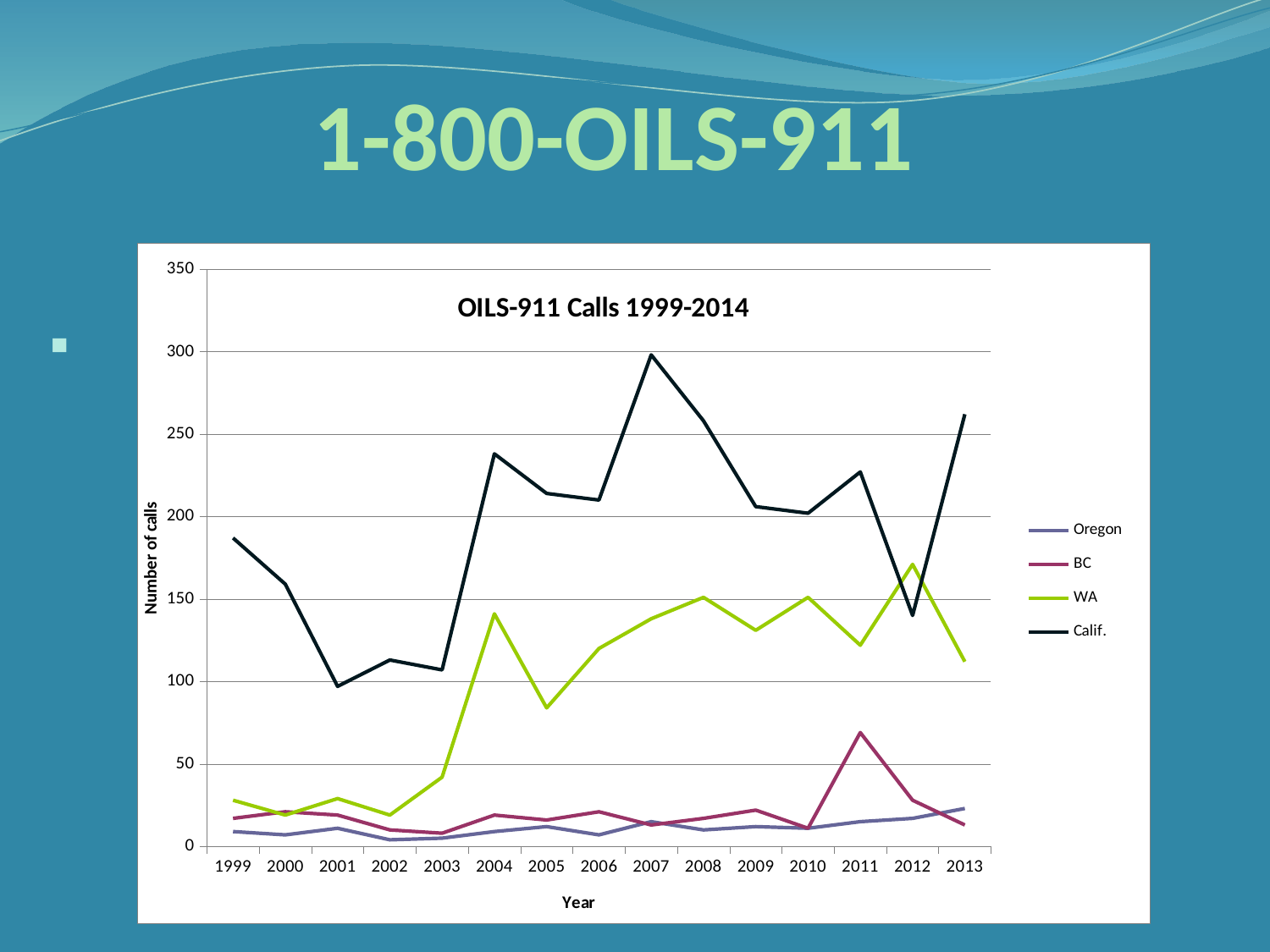
What kind of chart is shown on the slide? Line chart Is the value for BC in 2011 greater or less than 50? greater Is the value for WA in 2005 greater or less than 100? less What is the title of the chart? OILS-911 Calls 1999-2014 How many years are plotted along the x axis? 15 How many series does the legend list? 4 Does the BC series rise or fall from 2011 to 2012? Fall What is the label of the y axis? Number of calls In which year does the Calif. series reach its highest value? 2007 In 2012, which series is higher, WA or Calif.? WA Is the value for Calif. in 2007 greater or less than 250? greater Which series has the highest values across most of the chart? Calif.